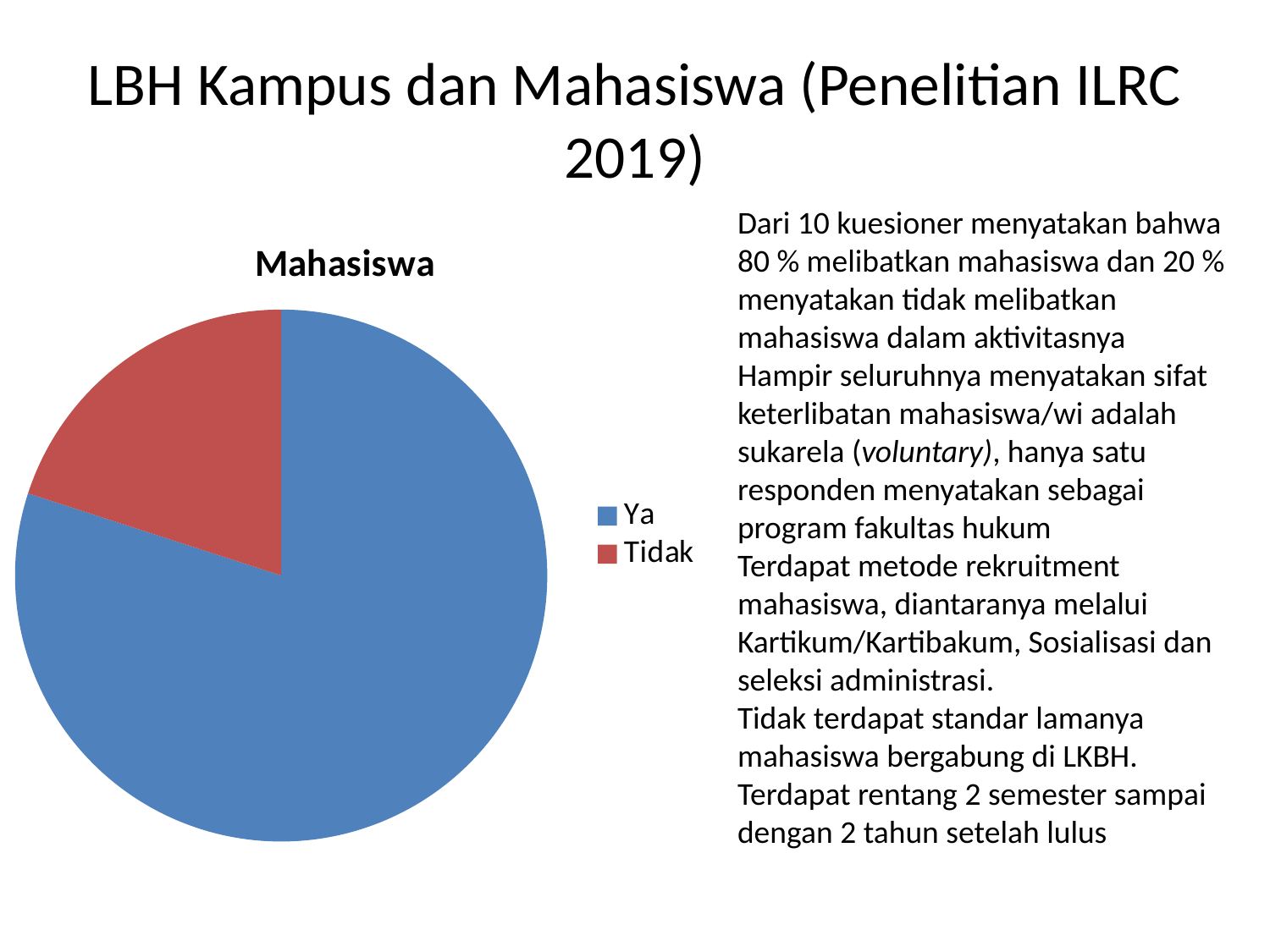
Which category has the smallest slice of the pie? Tidak How many slices does the pie chart have? 2 Which category has the largest slice of the pie? Ya What is the title of the chart? Mahasiswa Which slice is larger, Ya or Tidak? Ya What kind of chart is shown on the slide? pie chart What colour is the slice for Tidak? red How many entries does the legend list? 2